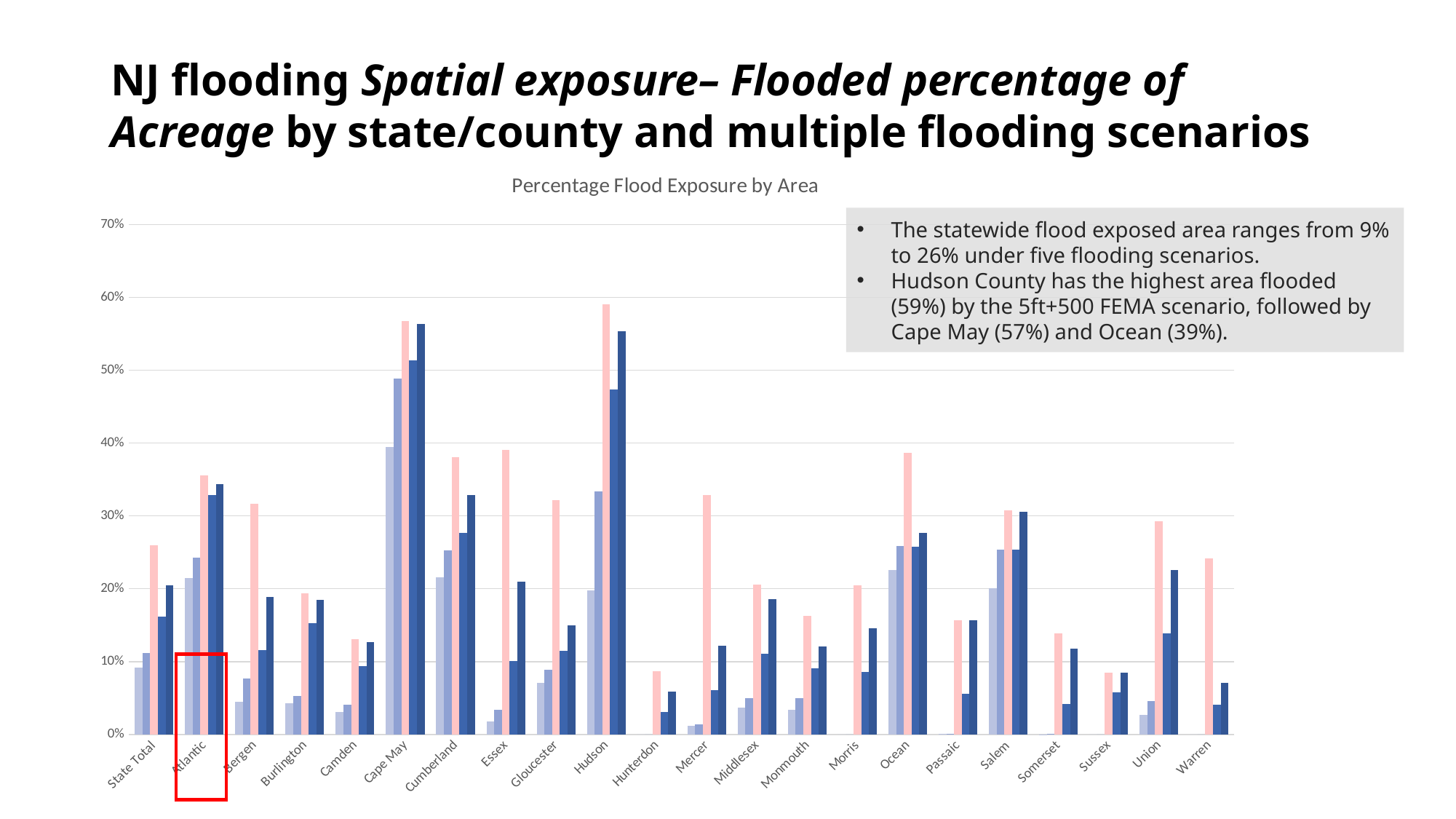
Which area has a taller tallest bar, Cape May or Ocean? Cape May Which area on the x axis is highlighted with a red box? Atlantic Which area has the tallest bar in the chart? Hudson Is the tallest bar for Cumberland greater or less than 40%? less How many areas (categories) are shown along the x axis of the chart? 22 Is the tallest bar for Warren greater or less than 20%? greater What is the title of the chart? Percentage Flood Exposure by Area What kind of chart is shown on the slide? bar chart Is the tallest bar for Hunterdon greater or less than 10%? less Which area has a taller tallest bar, Atlantic or Hudson? Hudson